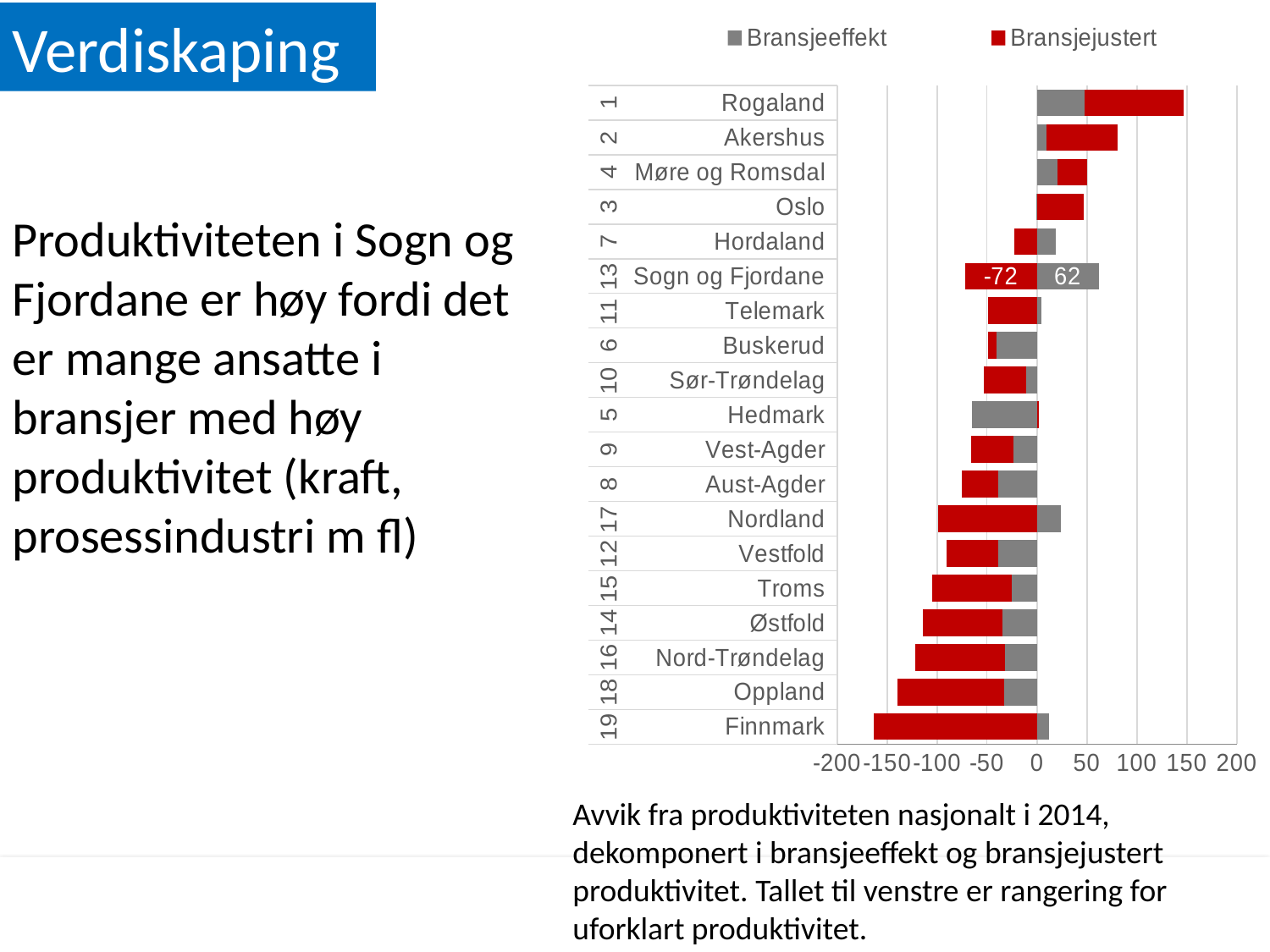
Which region has the largest Bransjeeffekt value? Sogn og Fjordane What is the Bransjeeffekt value for Sogn og Fjordane? 62 What kind of chart is shown on the slide? bar chart Which region has the lowest Bransjejustert value? Finnmark Which has the larger Bransjejustert value, Rogaland or Akershus? Rogaland What is the Bransjejustert value for Sogn og Fjordane? -72 What is the total of the two segments for Sogn og Fjordane? -10 How many series does the legend list? 2 How many regions are plotted in the chart? 19 Is the Bransjejustert value for Rogaland greater or less than 50? greater Is the Bransjejustert value for Finnmark greater or less than -100? less What colour represents the Bransjejustert series in the legend? red